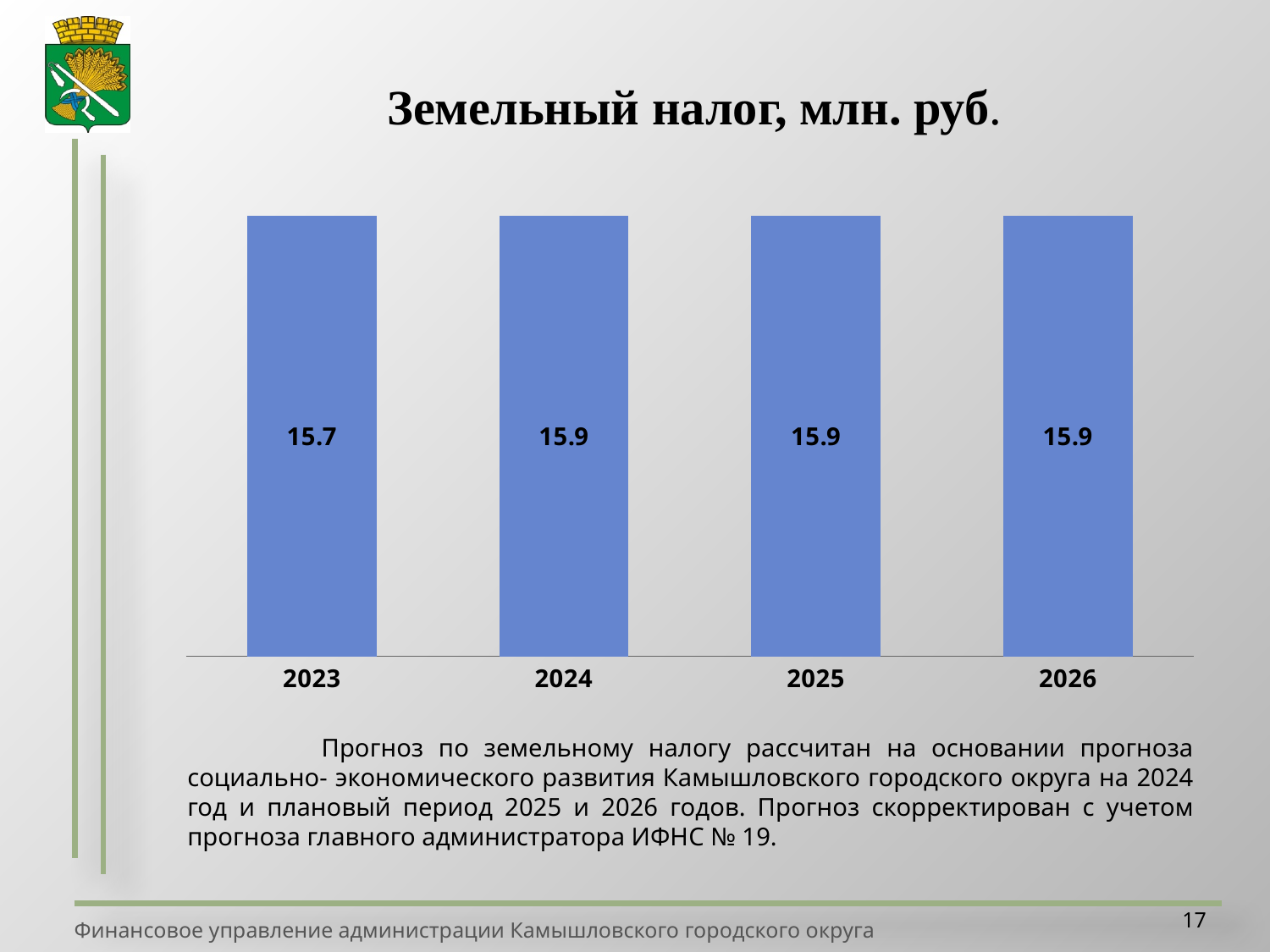
What is the title of the chart? Земельный налог, млн. руб. Which year has the lowest land tax value? 2023 What is the land tax value for 2024? 15.9 Which is larger, the land tax value for 2023 or for 2025? 2025 What is the land tax value for 2023? 15.7 How many years are shown on the chart? 4 What is the difference between the land tax values for 2024 and 2023? 0.2 What colour are the bars in the chart? blue Do the land tax values rise or fall from 2023 to 2024? rise What is the land tax value for 2026? 15.9 What type of chart is shown on the slide? bar chart Are the land tax values for 2024, 2025 and 2026 the same or different? the same